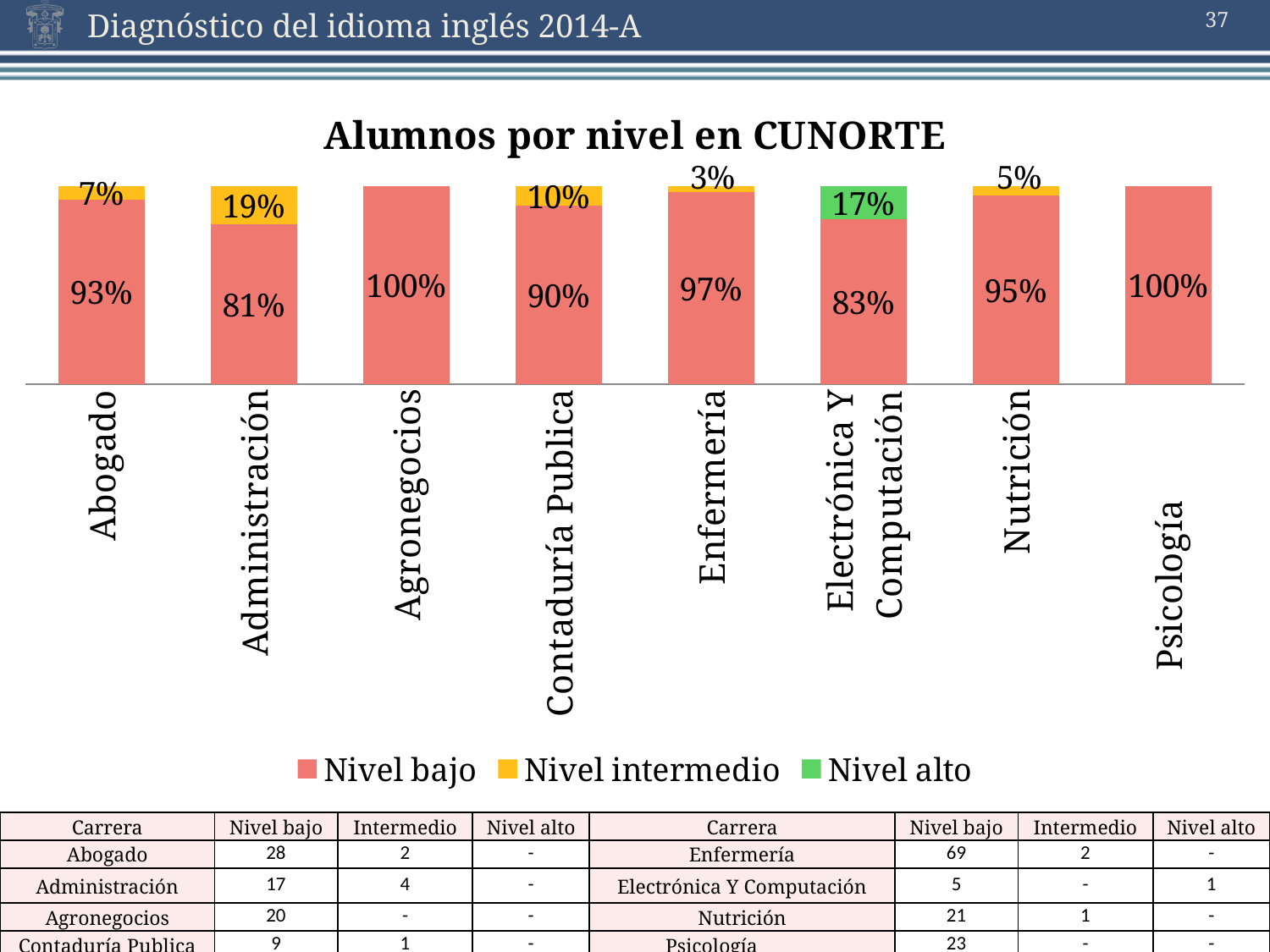
What is the title of the chart? Alumnos por nivel en CUNORTE How many series does the legend list? 3 What is the Nivel bajo percentage for Nutrición? 95% Which category has the highest Nivel intermedio percentage? Administración Which category has the lowest Nivel bajo percentage? Administración What is the Nivel intermedio percentage for Administración? 19% What kind of chart is shown on the slide? Stacked bar chart How many categories (carreras) are shown on the x axis of the chart? 8 What is the Nivel alto percentage for Electrónica Y Computación? 17% What is the Nivel bajo percentage for Abogado in the chart? 93% What is the difference between the Nivel bajo percentages of Enfermería and Contaduría Publica? 7% Which is larger, the Nivel bajo percentage for Abogado or for Electrónica Y Computación? Abogado